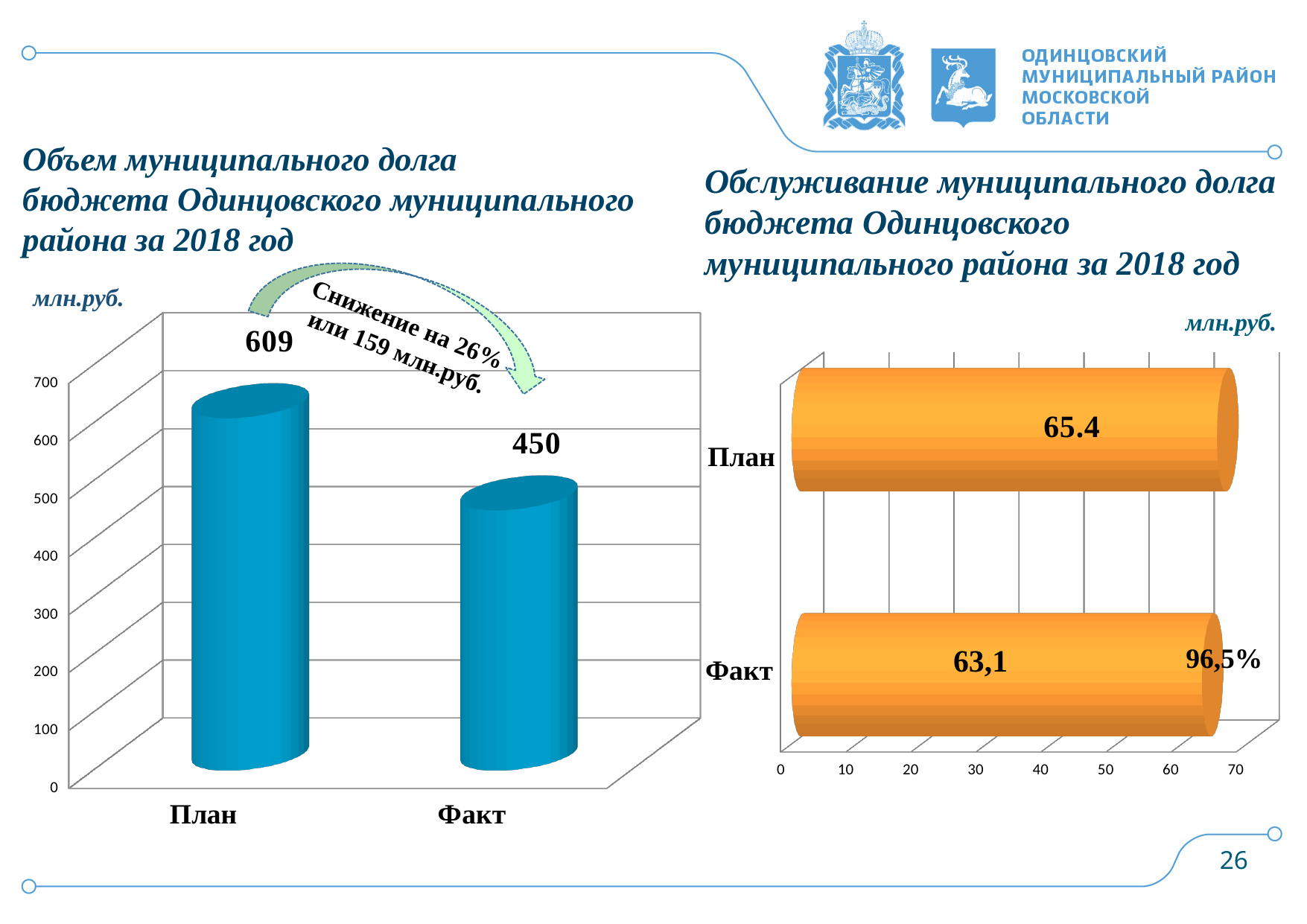
In the right chart (Обслуживание муниципального долга), what percentage is shown next to the Факт bar? 96,5% In the right chart (Обслуживание муниципального долга), what is the value for Факт? 63,1 In the left chart (Объем муниципального долга), what is the value for Факт? 450 What kind of chart is the left chart (Объем муниципального долга)? bar chart In the right chart (Обслуживание муниципального долга), which category has the lower value? Факт In the left chart (Объем муниципального долга), which category has the higher value, План or Факт? План In the left chart (Объем муниципального долга), how many bars are plotted? 2 In the right chart (Обслуживание муниципального долга), what is the value for План? 65.4 In the left chart (Объем муниципального долга), what is the value for План? 609 In the left chart (Объем муниципального долга), what is the difference between the План and Факт values? 159 In the right chart (Обслуживание муниципального долга), is the value for Факт greater or less than 60? greater What unit is indicated for the values in the left chart (Объем муниципального долга)? млн.руб.